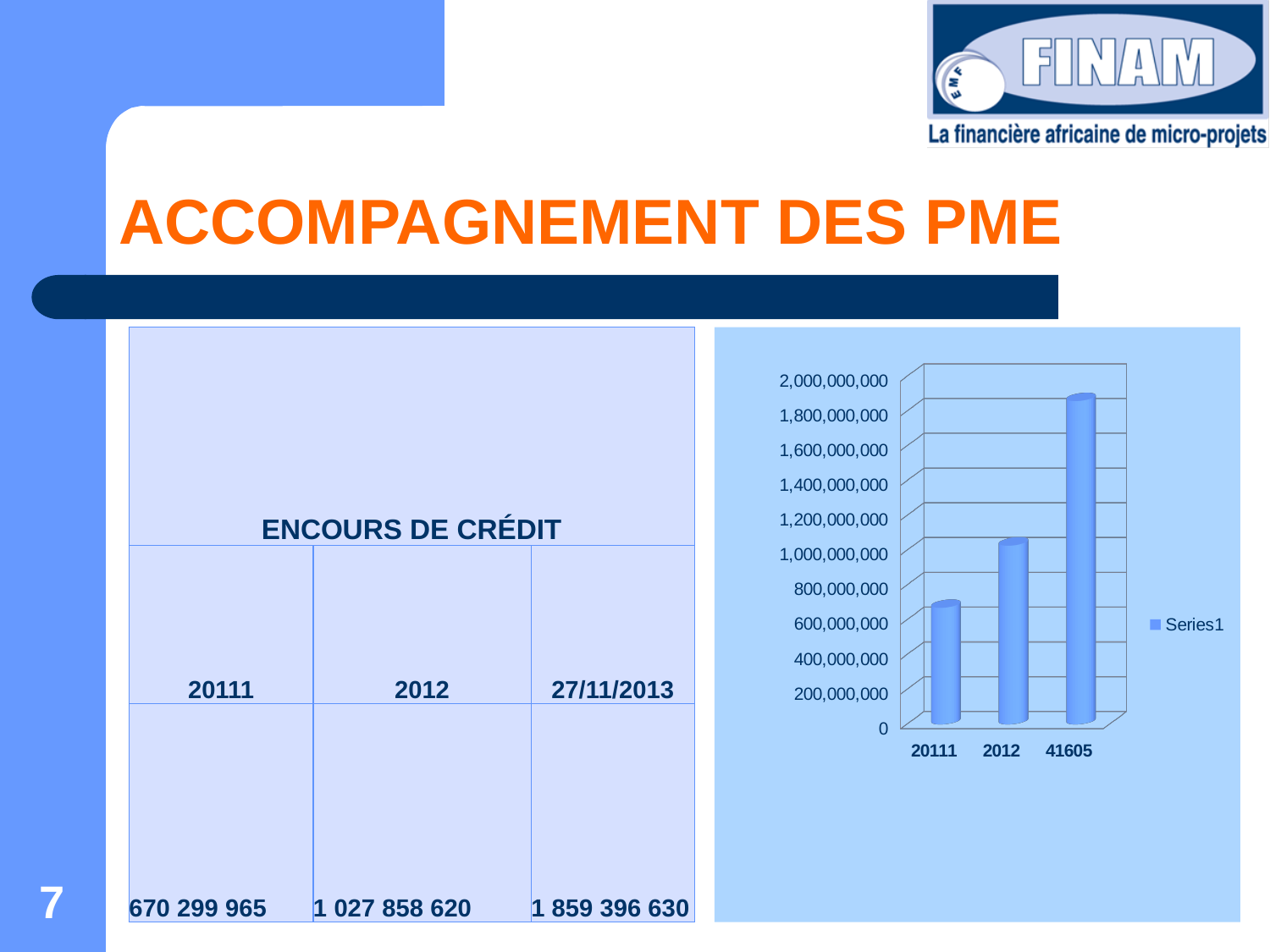
Is the value for 2012 in the chart greater or less than 1,200,000,000? less What is the name of the series shown in the chart legend? Series1 In the chart, which is larger, the value for 2012 or the value for 20111? 2012 What kind of chart is shown on the right side of the slide? bar chart Which category has the tallest bar in the chart? 41605 Is the value for 41605 in the chart greater or less than 1,600,000,000? greater How many series does the chart legend list? 1 Which category has the shortest bar in the chart? 20111 How many bars does the chart on the right show? 3 Do the bar values rise or fall from left to right along the x axis of the chart? rise Is the value for 20111 in the chart greater or less than 800,000,000? less